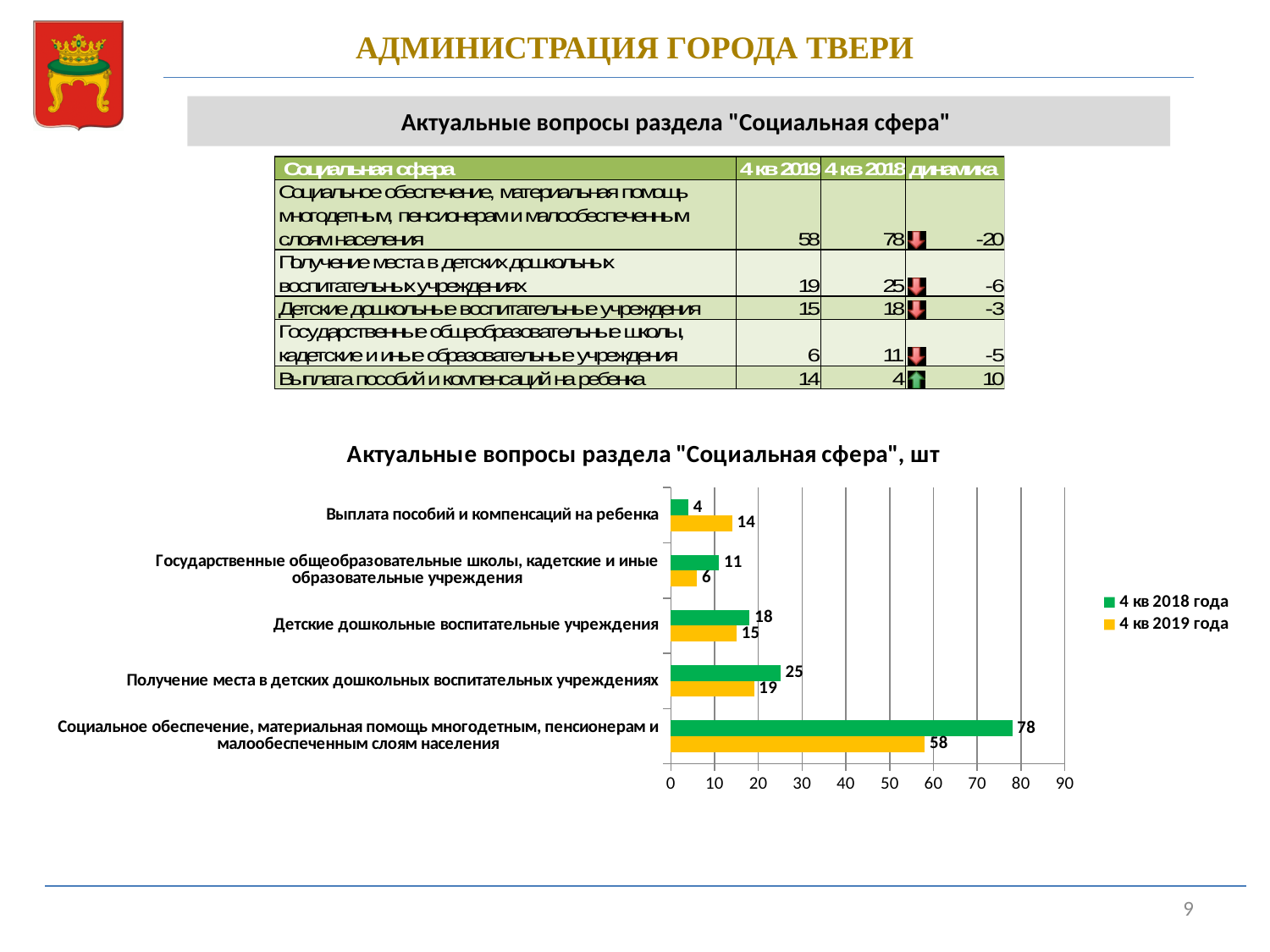
For "Выплата пособий и компенсаций на ребенка", which series has the larger value: "4 кв 2018 года" or "4 кв 2019 года"? 4 кв 2019 года Which category has the highest value in the "4 кв 2019 года" series? Социальное обеспечение, материальная помощь многодетным, пенсионерам и малообеспеченным слоям населения What is the title of the chart? Актуальные вопросы раздела "Социальная сфера", шт Is the "4 кв 2019 года" value for "Социальное обеспечение, материальная помощь многодетным, пенсионерам и малообеспеченным слоям населения" greater or less than 50? greater How many categories are shown on the chart? 5 What is the difference between the "4 кв 2018 года" and "4 кв 2019 года" values for "Получение места в детских дошкольных воспитательных учреждениях"? 6 What is the value for "Социальное обеспечение, материальная помощь многодетным, пенсионерам и малообеспеченным слоям населения" in the "4 кв 2018 года" series? 78 Which category has the lowest value in the "4 кв 2018 года" series? Выплата пособий и компенсаций на ребенка How many series does the legend list? 2 What is the value for "Детские дошкольные воспитательные учреждения" in the "4 кв 2019 года" series? 15 What type of chart is shown on the slide? bar chart What is the value for "Выплата пособий и компенсаций на ребенка" in the "4 кв 2019 года" series? 14